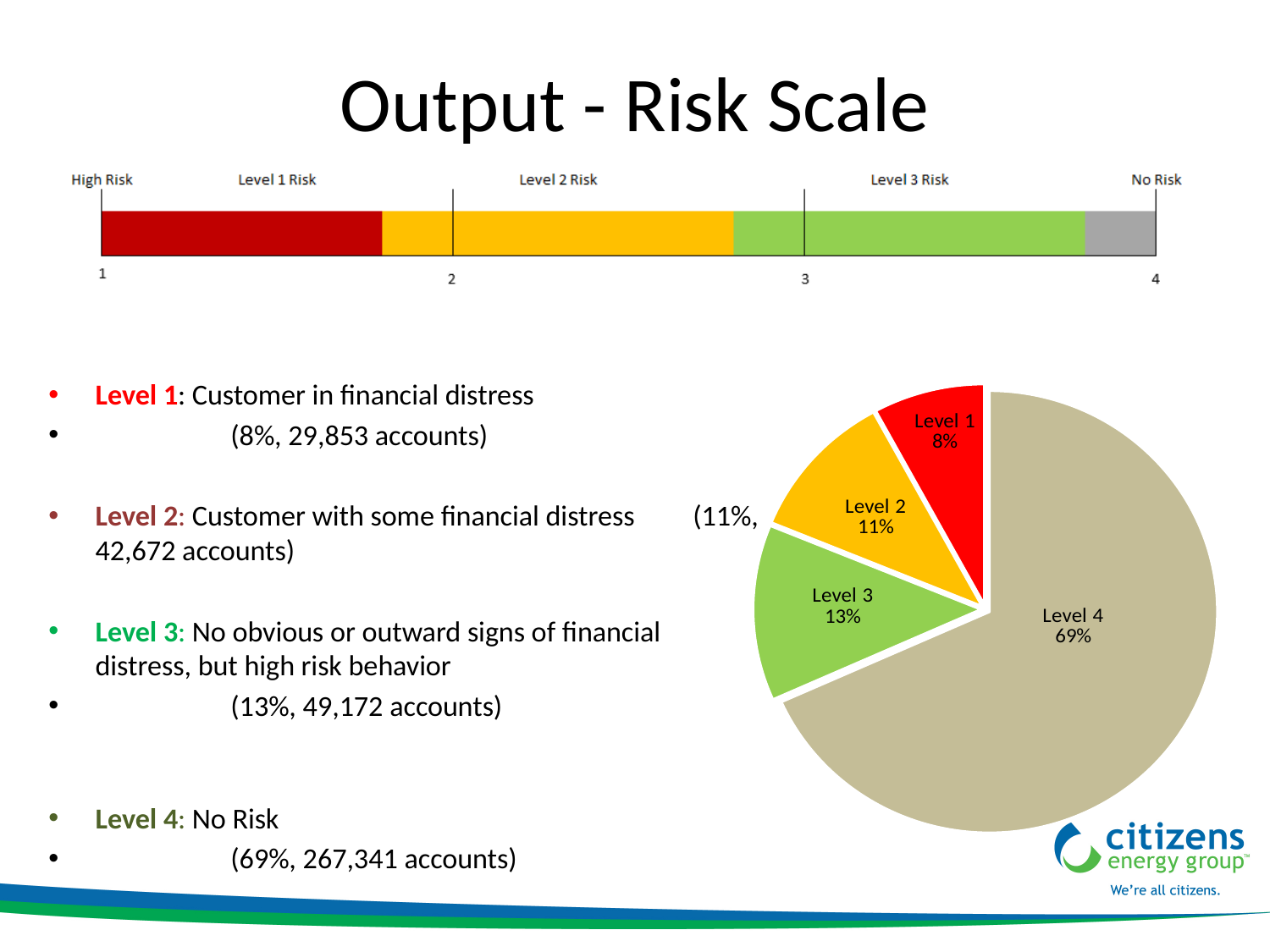
What colour is the Level 1 slice of the pie chart? red What kind of chart is shown on the slide? pie chart What is the value shown for Level 3 in the pie chart? 13% What is the difference in percentage points between Level 2 and Level 1? 3 What is the value shown for Level 2 in the pie chart? 11% Which level has the smallest slice of the pie? Level 1 What is the difference in percentage points between Level 4 and Level 3? 56 What share of the pie does Level 4 represent? 69% Which slice is larger, Level 2 or Level 3? Level 3 How many slices does the pie chart have? 4 Which level has the largest slice of the pie? Level 4 What share of the pie does Level 1 represent? 8%